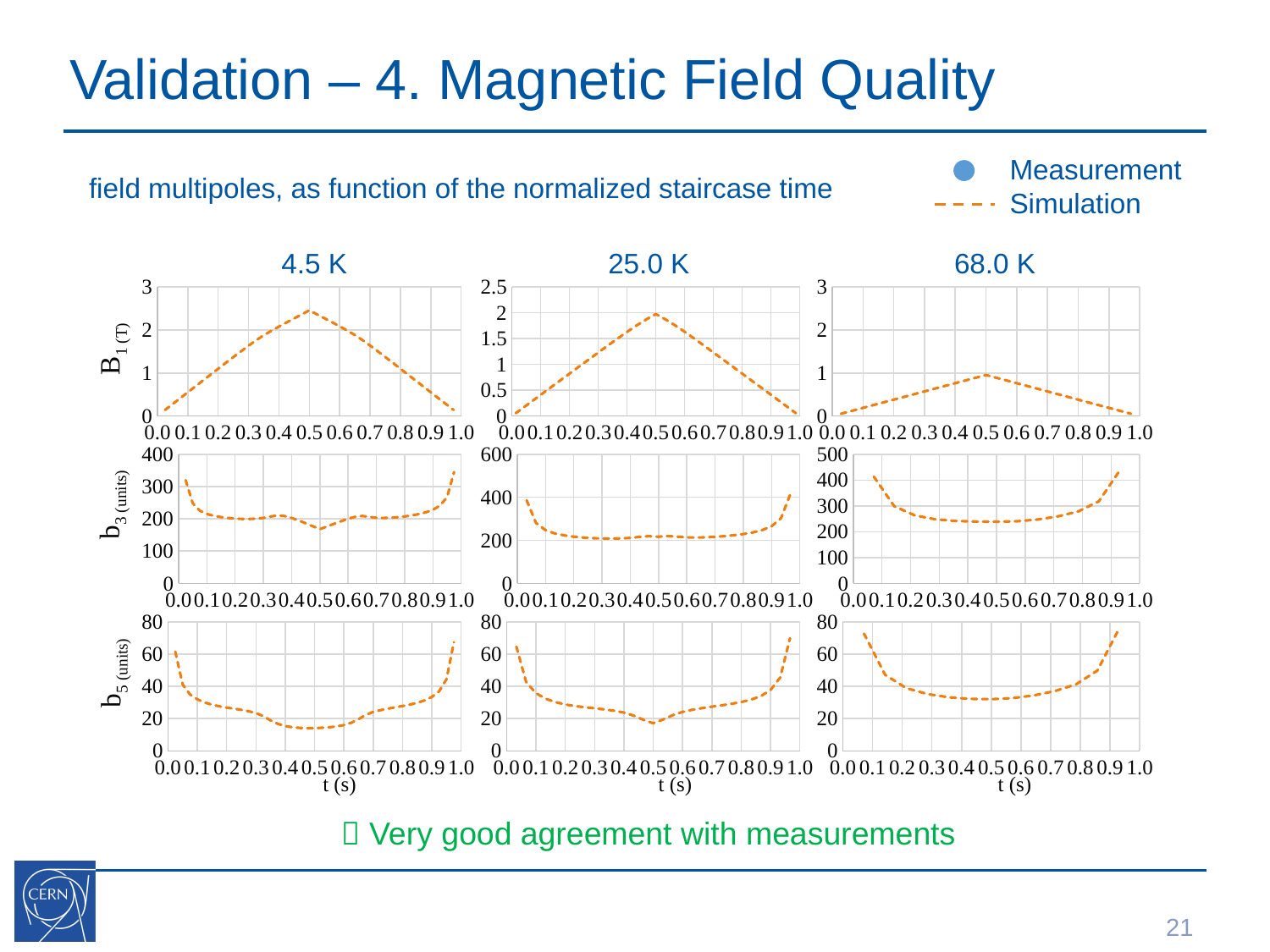
In the B1 (T) chart at 4.5 K, is the value at t = 0.5 greater or less than 2? greater In the B1 (T) chart at 25.0 K, does the value rise or fall between t = 0.5 and t = 1.0? fall How many series does the legend list? 2 In the B1 (T) chart at 68.0 K, is the value at t = 0.5 greater or less than 2? less What kind of chart is used for the B1 (T) plot at 4.5 K? line chart How many charts are shown on the slide? 9 In the B1 (T) chart at 4.5 K, does the value rise or fall between t = 0.0 and t = 0.5? rise Comparing the B1 (T) charts, which temperature has the higher peak value at t = 0.5: 4.5 K or 68.0 K? 4.5 K What is the x-axis label on the bottom row of charts? t (s) In the b5 (units) chart at 68.0 K, is the value at t = 0.5 greater or less than 40? less What are the two entries in the legend? Measurement and Simulation